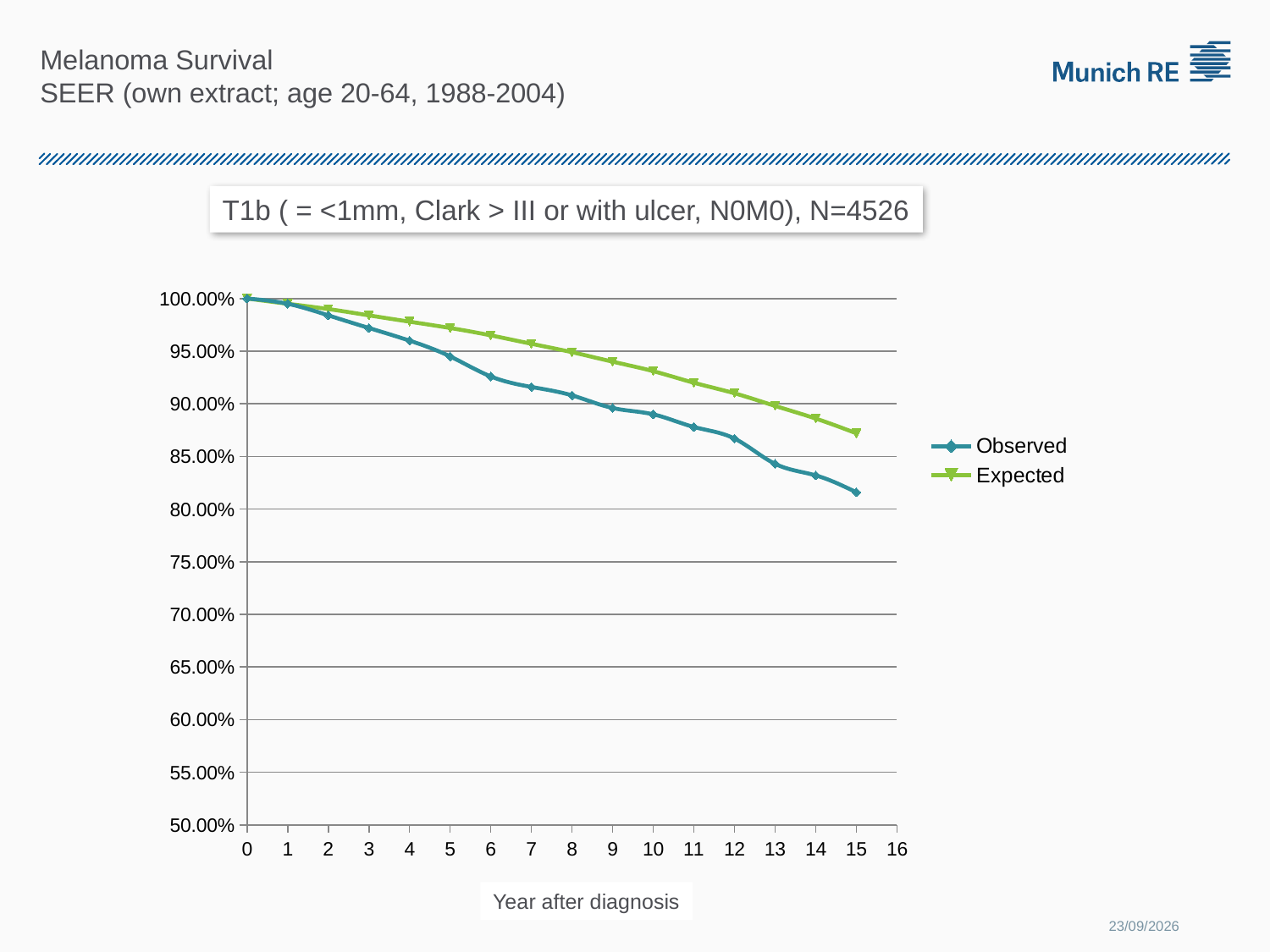
What kind of chart is shown on the slide? line chart How many data points does the Observed series have (years 0 through 15)? 16 What is the x-axis title of the chart? Year after diagnosis What is the Observed value at year 0? 100.00% Do the Observed values rise or fall as the year after diagnosis increases? fall How many series does the legend list? 2 Is the Observed value at year 15 greater or less than 85.00%? less Is the Expected value at year 15 greater or less than 85.00%? greater What are the two series named in the legend? Observed and Expected Is the Expected value at year 10 greater or less than 90.00%? greater At year 15, which series has the higher value, Observed or Expected? Expected